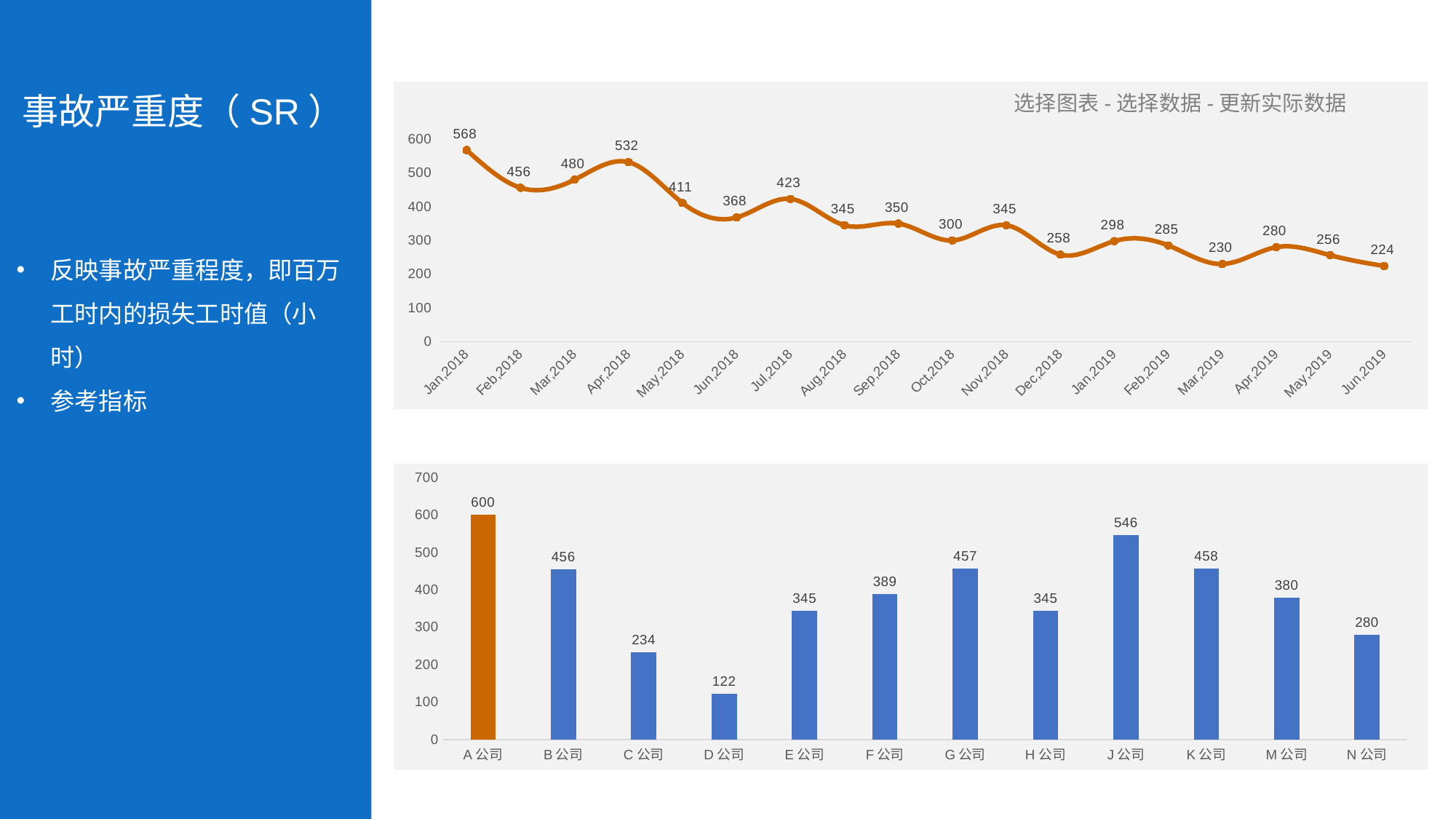
In the top line chart, which month has the highest value? Jan,2018 In the top line chart, what is the value for Apr,2018? 532 In the top line chart, what is the difference between the values for Jan,2018 and Feb,2018? 112 In the bottom bar chart, what is the value for J 公司? 546 In the top line chart, how many data points are plotted? 18 In the bottom bar chart, how many companies are shown? 12 In the top line chart, what is the value for Jun,2019? 224 In the bottom bar chart, which is larger, the value for F 公司 or the value for M 公司? F 公司 In the top line chart, do the values generally rise or fall from Jan,2018 to Jun,2019? fall In the bottom bar chart, which company has the lowest value? D 公司 In the bottom bar chart, which company has the highest value? A 公司 In the top line chart, which month has the lowest value? Jun,2019